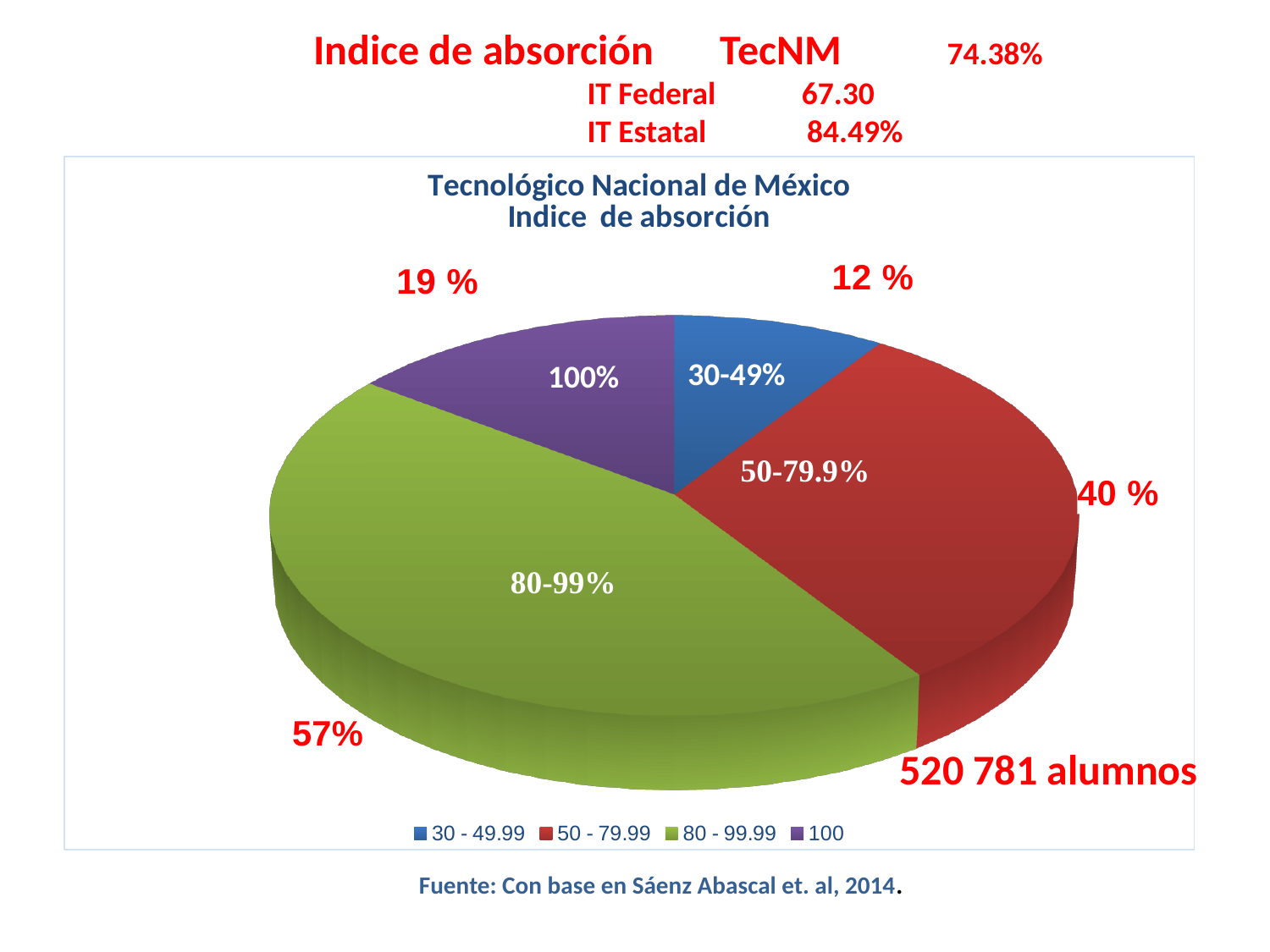
Which category has the largest slice in the pie chart? 80-99.99 Which slice is larger in the pie chart, 50-79.99 or 100? 50-79.99 What percentage is shown for the 100 slice of the pie chart? 19 % What is the difference in percentage points between the 80-99.99 slice and the 50-79.99 slice? 17 What percentage is shown for the 80-99.99 slice of the pie chart? 57% What kind of chart is shown on the slide? pie chart How many entries does the legend of the pie chart list? 4 What percentage is shown for the 50-79.99 slice of the pie chart? 40 % What is the title of the pie chart? Tecnológico Nacional de México Indice de absorción How many slices does the pie chart have? 4 What percentage is shown for the 30-49.99 slice of the pie chart? 12 % Which category has the smallest slice in the pie chart? 30-49.99